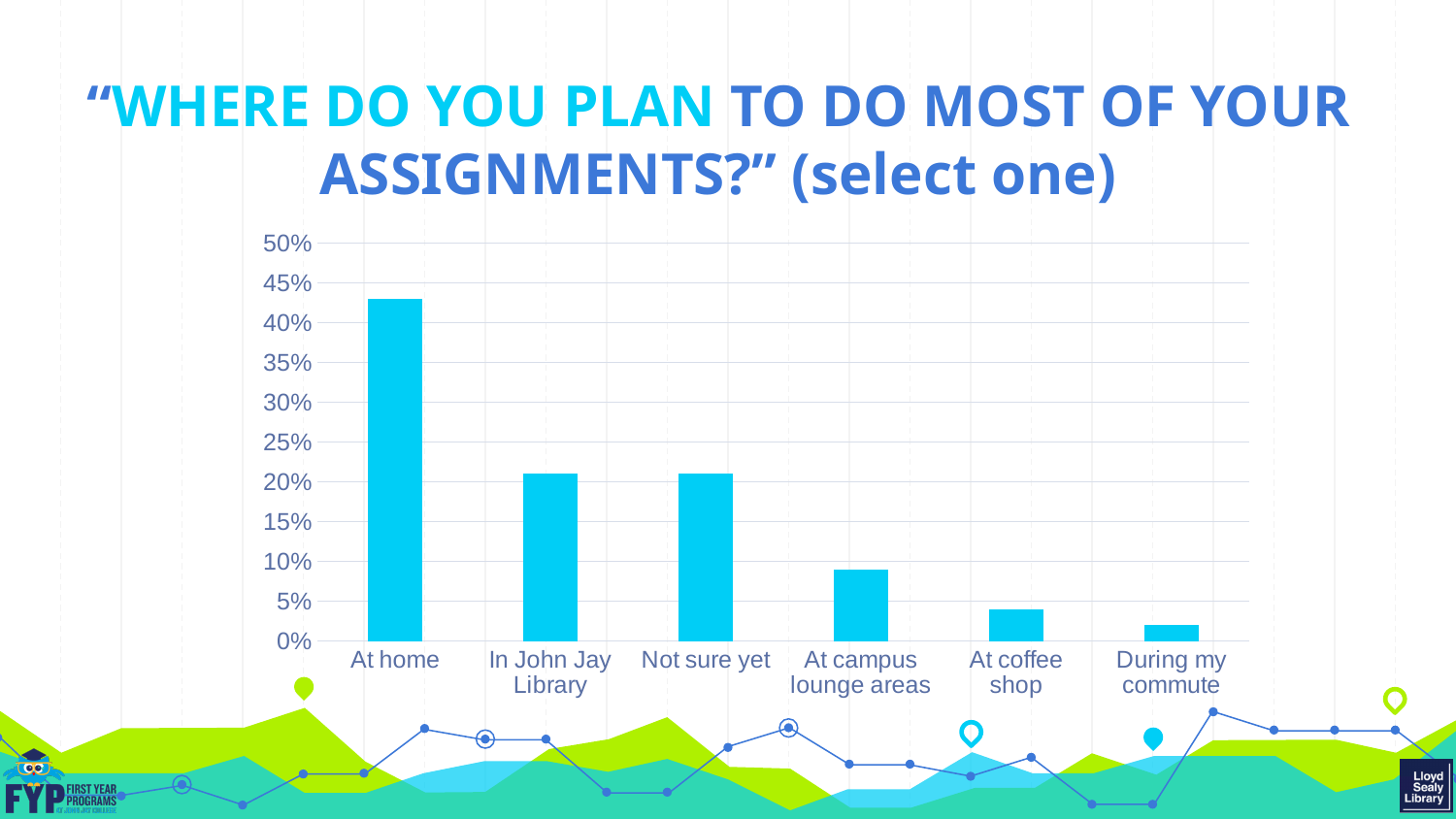
Which category has the lowest value in the chart? During my commute Is the value for Not sure yet greater or less than 15%? greater Is the value for At home greater or less than 40%? greater Which is larger, the value for At home or the value for Not sure yet? At home Is the value for In John Jay Library greater or less than 25%? less How many categories are shown on the x axis of the chart? 6 Which category has the highest value in the chart? At home Which is larger, the value for At coffee shop or the value for During my commute? At coffee shop What is the highest value shown on the y axis of the chart? 50% What kind of chart is shown on the slide? bar chart